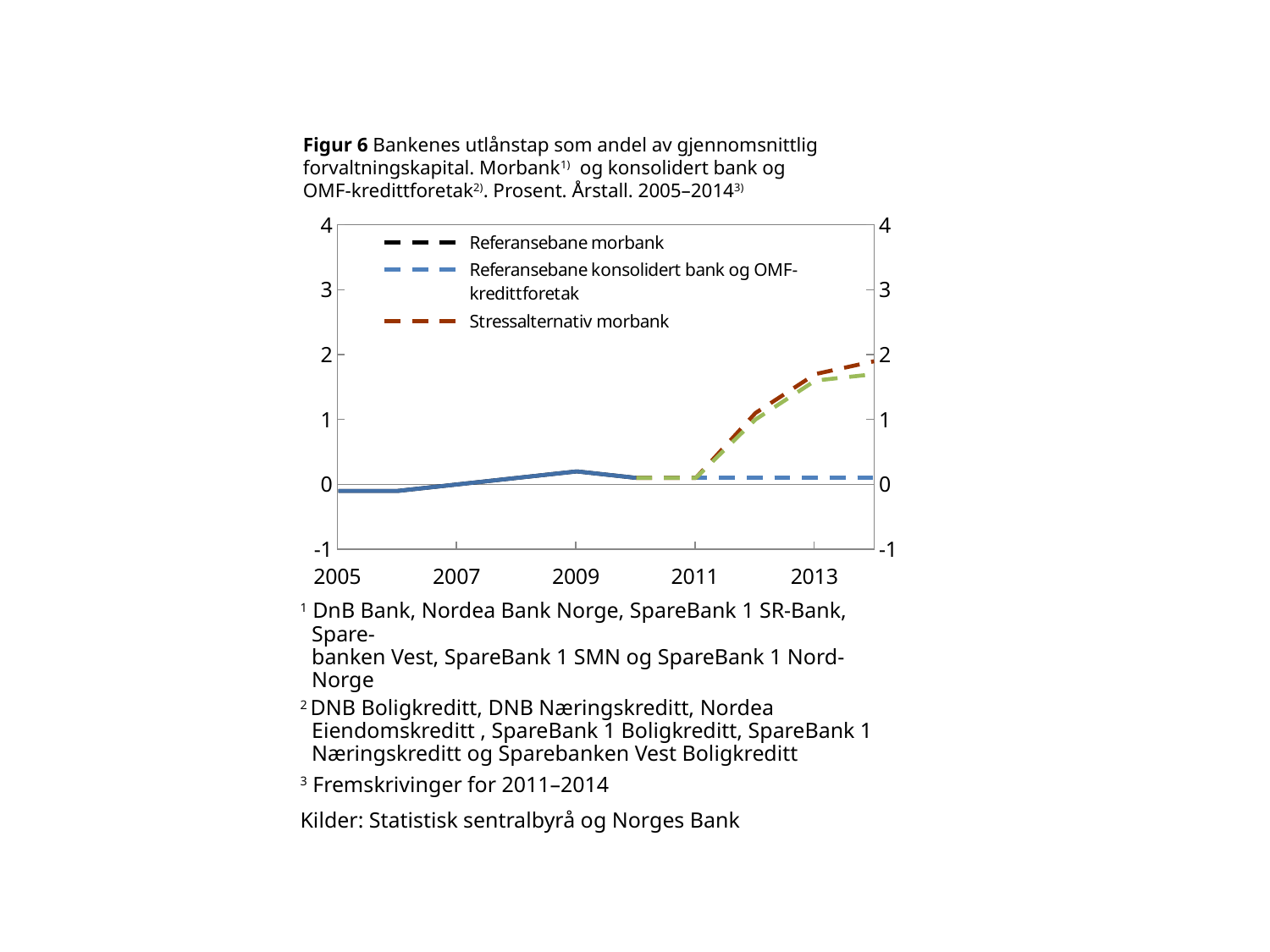
Is the value for Stressalternativ morbank in 2014 greater or less than 2? less Is the value for Stressalternativ morbank in 2014 greater or less than 1? greater How many series does the legend list? 3 What kind of chart is shown on the slide? line chart What is the highest value shown on the y axis? 4 Is the value for Stressalternativ morbank in 2012 greater or less than 0? greater Which series is drawn with a red-brown dashed line? Stressalternativ morbank How many year labels are shown on the x axis? 5 In 2014, which is higher: Stressalternativ morbank or Referansebane konsolidert bank og OMF-kredittforetak? Stressalternativ morbank What is the figure number given in the chart title? Figur 6 Does the Stressalternativ morbank line rise or fall from 2011 to 2014? rise